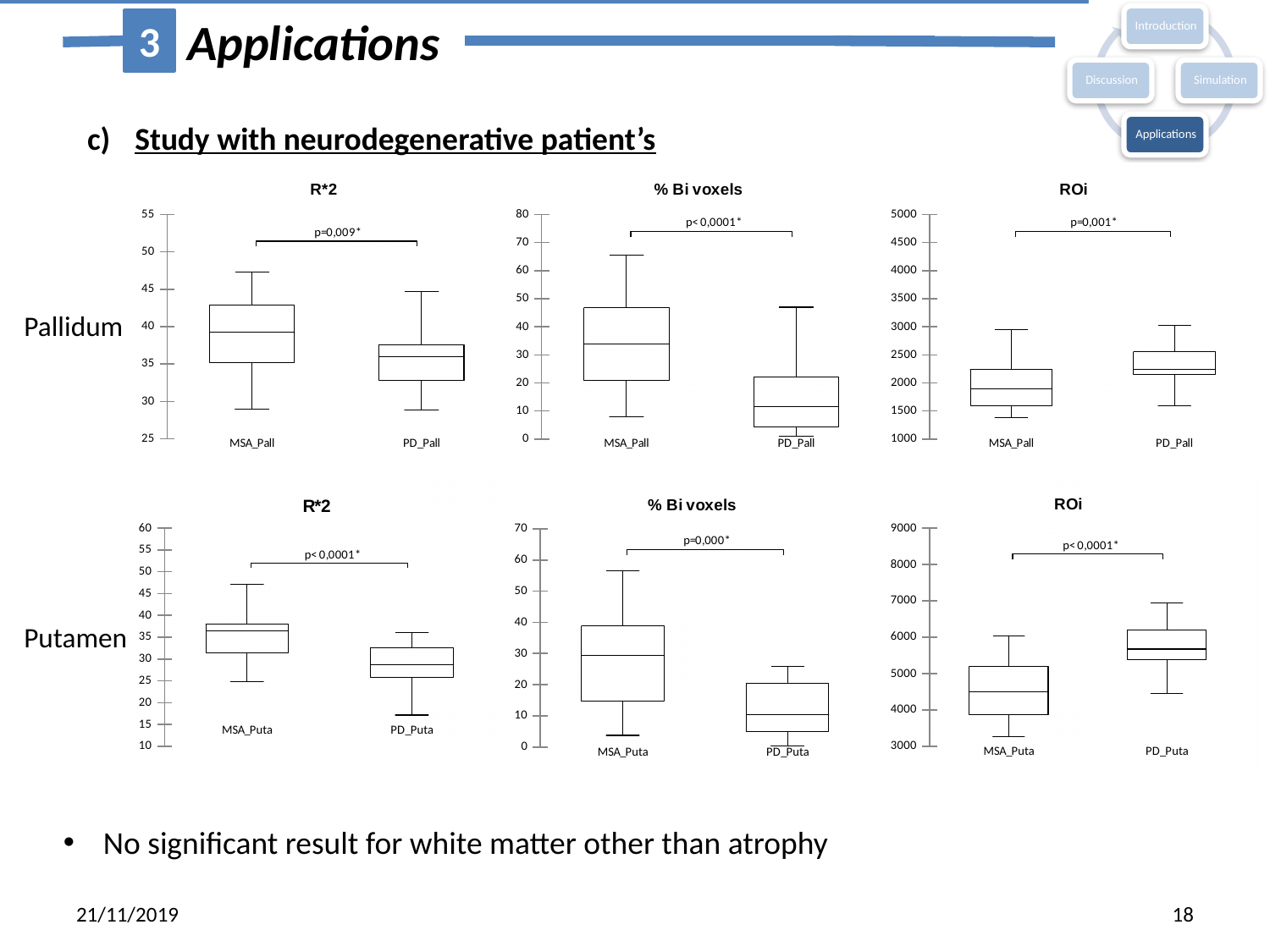
How many groups are plotted in the Pallidum % Bi voxels chart? 2 In the Putamen ROi chart, is the median for PD_Puta greater or less than 5000? greater In the Putamen R*2 chart, which group has the higher median, MSA_Puta or PD_Puta? MSA_Puta In the Putamen % Bi voxels chart, is the median for PD_Puta greater or less than 20? less In the Pallidum % Bi voxels chart, which group has the higher median, MSA_Pall or PD_Pall? MSA_Pall What p-value is printed on the Putamen ROi chart? p< 0,0001* What p-value is printed on the Pallidum R*2 chart? p=0,009* In the Pallidum ROi chart, is the median for PD_Pall greater or less than 2000? greater In the Pallidum ROi chart, which group has the higher median, MSA_Pall or PD_Pall? PD_Pall What kind of chart is the Pallidum R*2 chart? Box plot